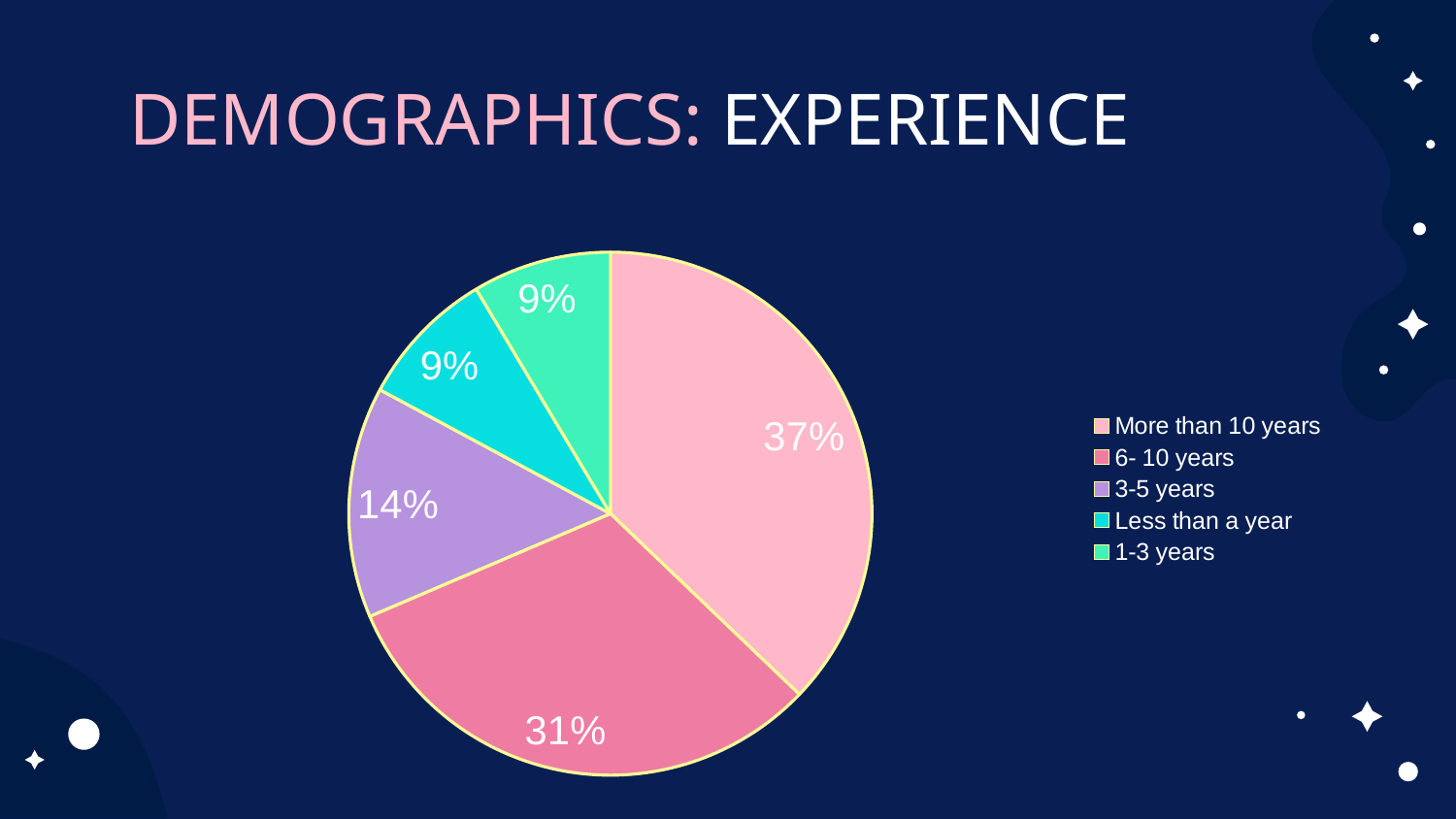
What is the title of the slide containing the chart? DEMOGRAPHICS: EXPERIENCE How many entries does the legend list? 5 What share of the pie is labelled for 'More than 10 years'? 37% How many slices does the pie chart have? 5 Which slice is larger: '3-5 years' or '1-3 years'? 3-5 years What percentage is shown for the 'Less than a year' slice? 9% What percentage is shown for the '6- 10 years' slice? 31% What type of chart is shown on the slide? Pie chart What is the smallest percentage shown on any slice? 9% What is the difference in percentage points between the 'More than 10 years' slice and the '6- 10 years' slice? 6 What percentage is shown for the '3-5 years' slice? 14% Which category has the largest slice of the pie? More than 10 years